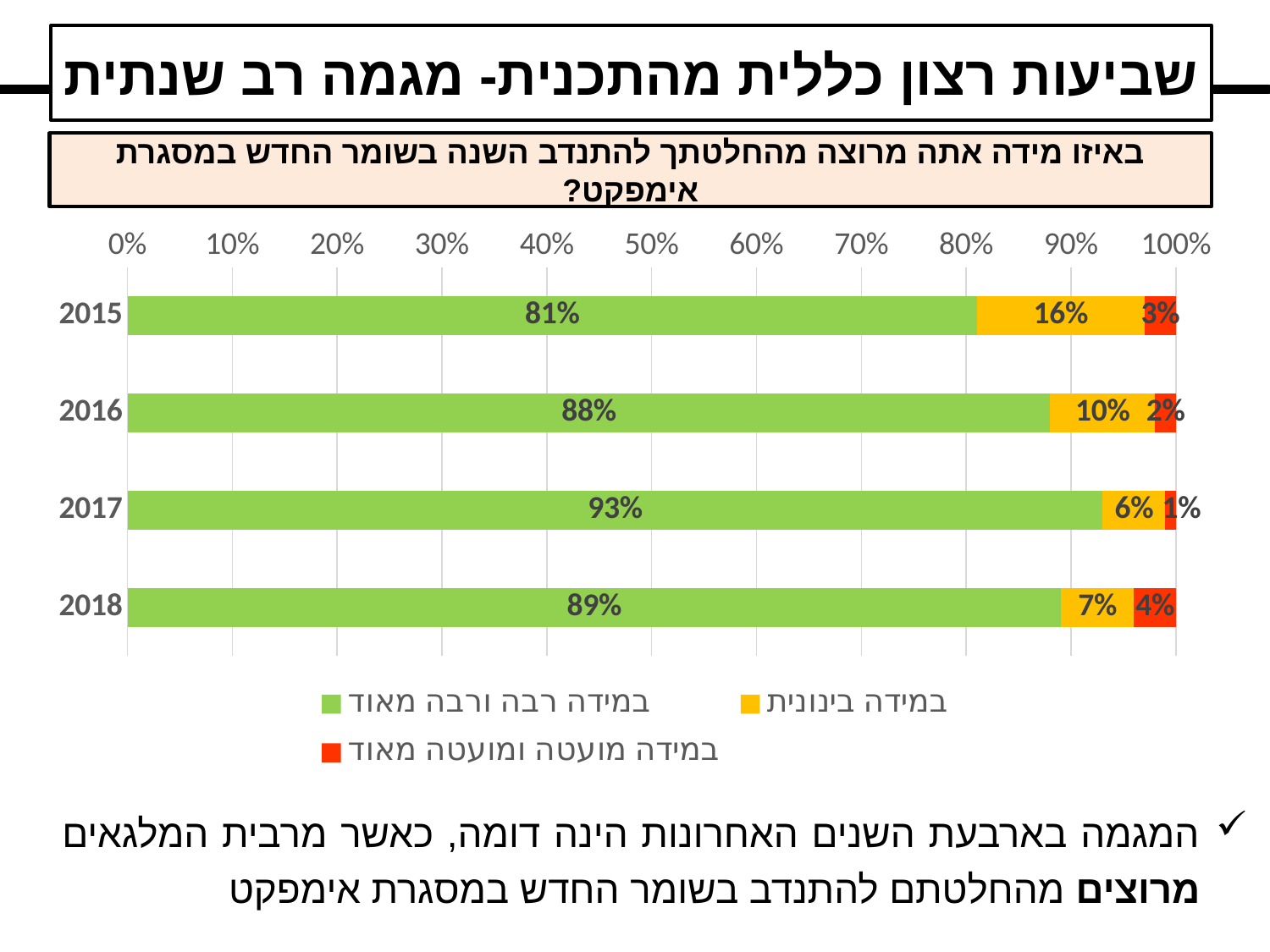
What is the value for "במידה רבה ורבה מאוד" in 2016? 88% How many series does the legend list? 3 What is the difference between the "במידה רבה ורבה מאוד" values for 2017 and 2015? 12% Which colour represents "במידה מועטה ומועטה מאוד" in the chart? Red What is the value for "במידה בינונית" in 2015? 16% How many years are shown on the chart? 4 What is the value for "במידה רבה ורבה מאוד" in 2017? 93% Which is larger: the "במידה בינונית" value for 2016 or for 2018? 2016 What is the value for "במידה מועטה ומועטה מאוד" in 2018? 4% Which year has the lowest value for "במידה בינונית"? 2017 Which year has the highest value for "במידה רבה ורבה מאוד"? 2017 What kind of chart is shown on the slide? Stacked bar chart